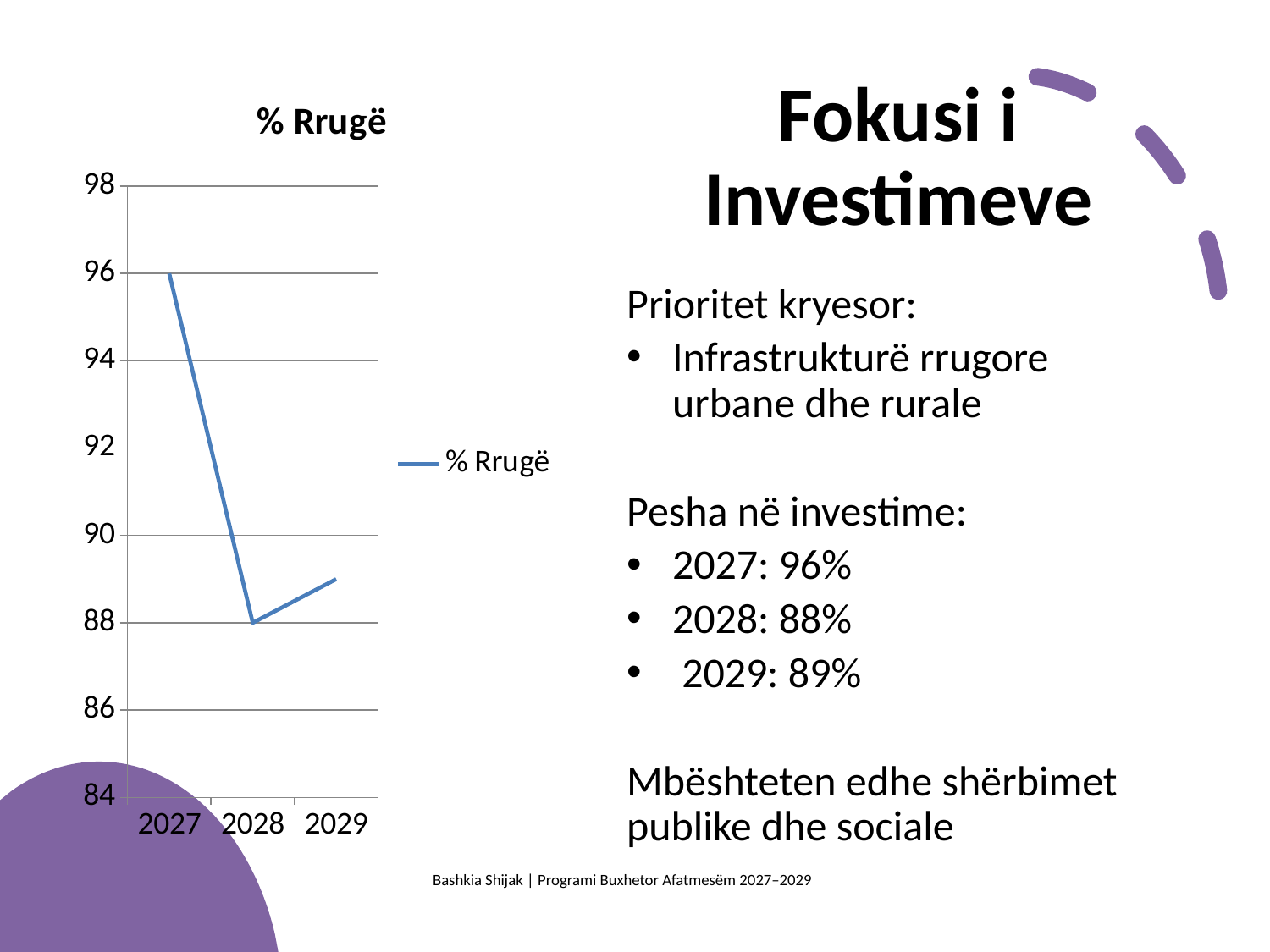
What is the value for 2028 in the chart? 88 Which is larger, the value for 2027 or the value for 2029? 2027 What is the value for 2027 in the chart? 96 How many series does the chart legend list? 1 What is the title of the chart? % Rrugë Is the value for 2029 greater or less than 90? less Which year has the lowest value in the chart? 2028 What is the difference between the values for 2027 and 2028? 8 What kind of chart is shown on the slide? line chart Does the line rise or fall from 2027 to 2028? fall Which year has the highest value in the chart? 2027 How many years are plotted on the x axis of the chart? 3